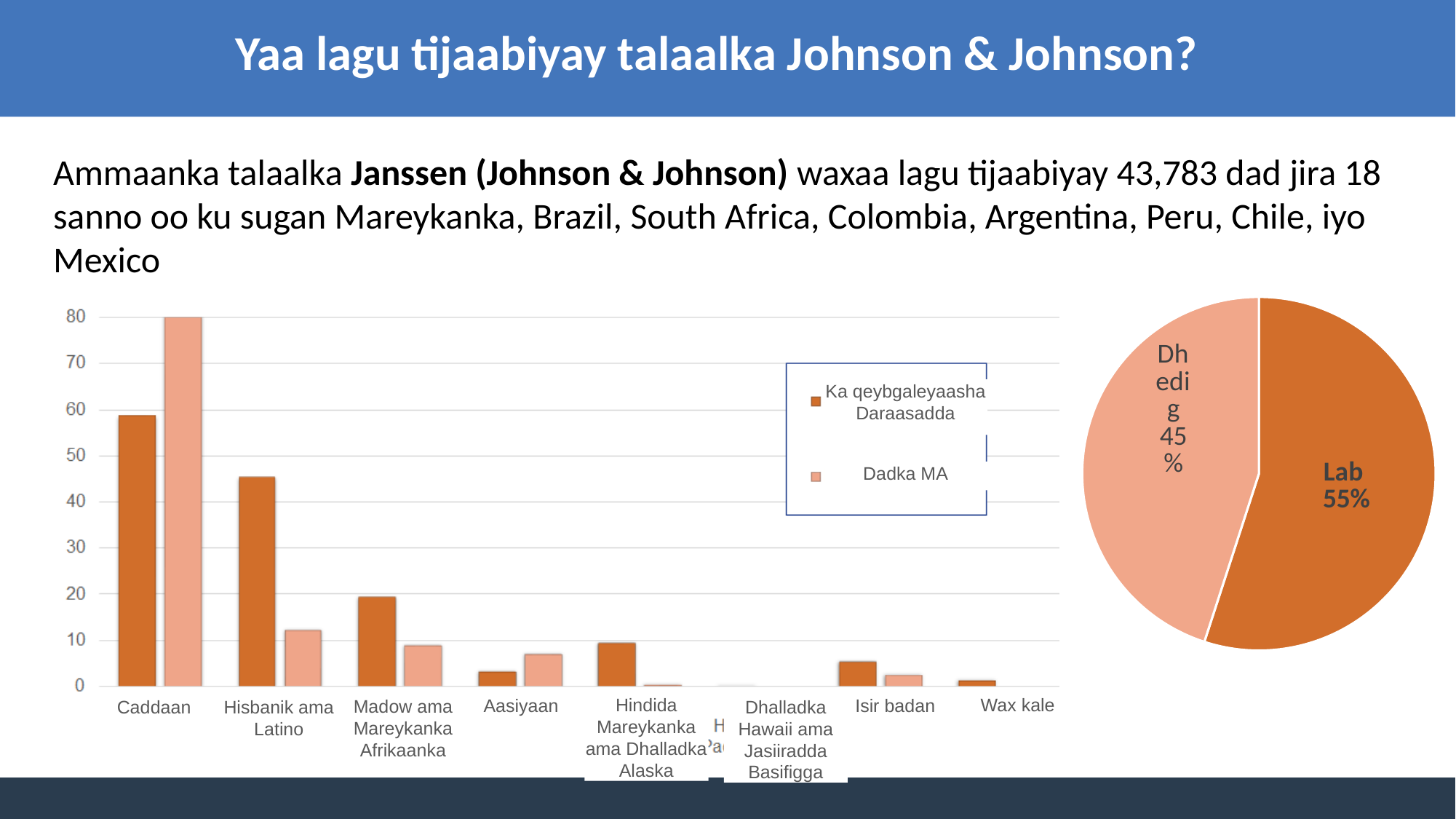
How many categories are shown on the x axis of the bar chart on the left? 8 In the bar chart on the left, is the Ka qeybgaleyaasha Daraasadda value for Madow ama Mareykanka Afrikaanka greater or less than 10? greater In the bar chart on the left, for Hisbanik ama Latino, which series has the larger value? Ka qeybgaleyaasha Daraasadda In the pie chart on the right, which slice is larger, Lab or Dhedig? Lab In the bar chart on the left, is the Dadka MA value for Caddaan greater or less than 70? greater In the pie chart on the right, what share does the Dhedig slice have? 45% In the pie chart on the right, what share does the Lab slice have? 55% In the bar chart on the left, which category has the highest value for Ka qeybgaleyaasha Daraasadda? Caddaan How many slices does the pie chart on the right have? 2 What kind of chart is the chart on the left of the slide? bar chart In the pie chart on the right, what is the difference between the Lab share and the Dhedig share? 10% How many series does the legend of the bar chart on the left list? 2